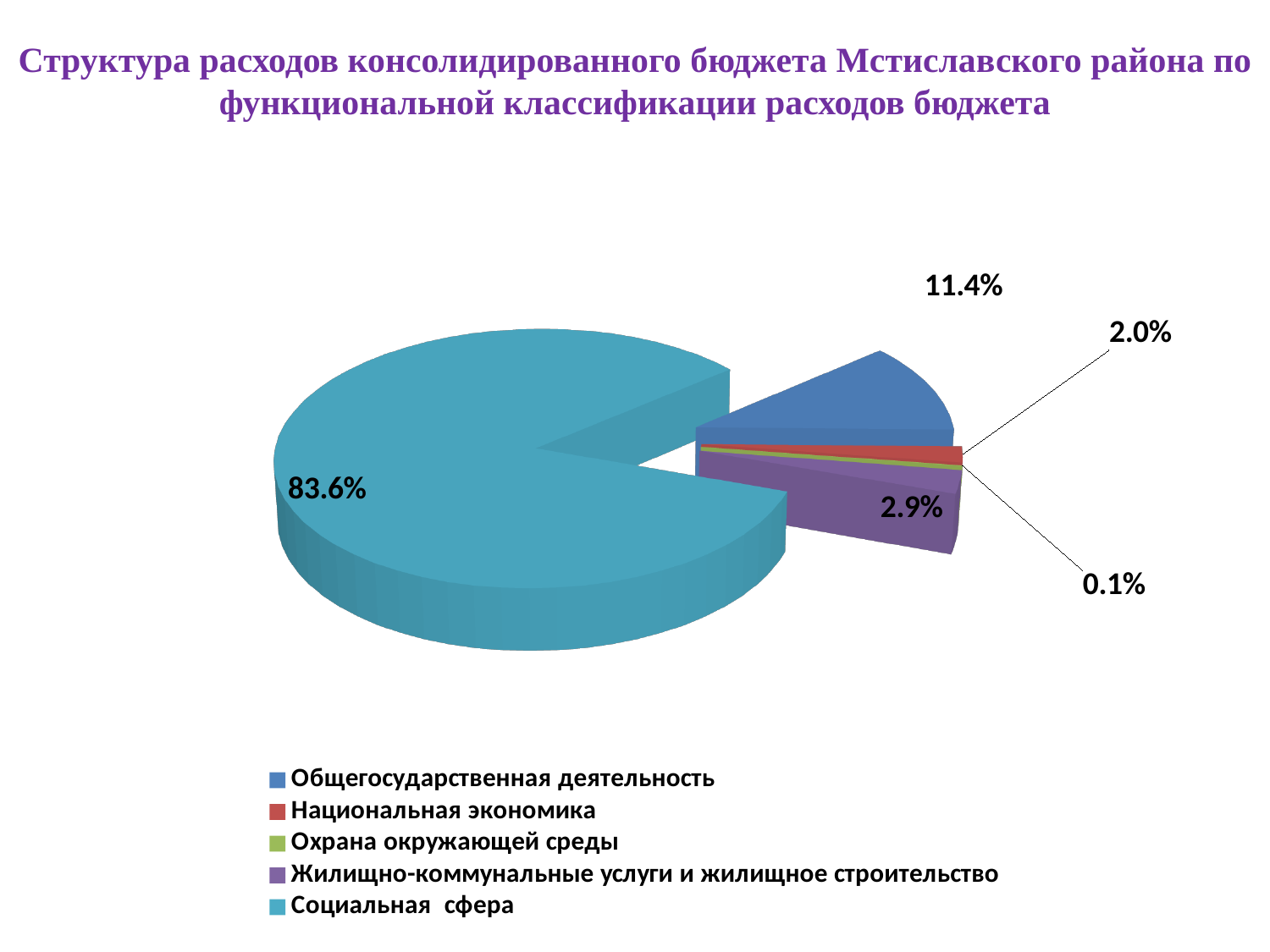
What is the value for Жилищно-коммунальные услуги и жилищное строительство? 2.9% What kind of chart is shown on the slide? pie chart What is the value for Национальная экономика? 2.0% Which category has the largest share of the pie? Социальная сфера What is the value for Общегосударственная деятельность? 11.4% What is the difference between the shares of Общегосударственная деятельность and Жилищно-коммунальные услуги и жилищное строительство? 8.5% Which is larger: the share of Национальная экономика or the share of Жилищно-коммунальные услуги и жилищное строительство? Жилищно-коммунальные услуги и жилищное строительство What share of expenditures does Социальная сфера account for? 83.6% What colour is the slice for Социальная сфера? teal (light blue) How many categories does the legend list? 5 Which category has the smallest share of the pie? Охрана окружающей среды What is the value for Охрана окружающей среды? 0.1%